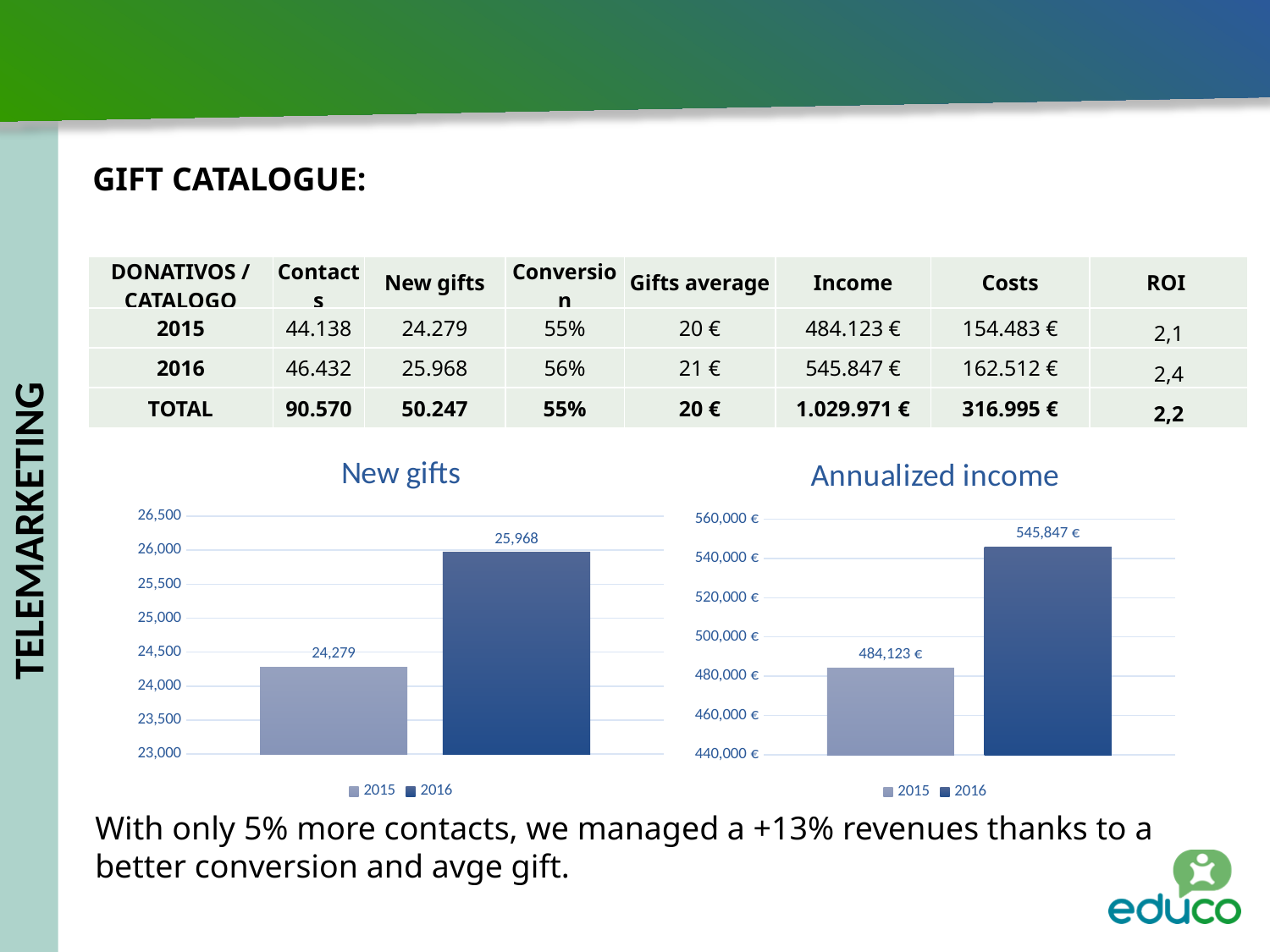
In the "New gifts" chart, what is the difference between the 2016 and 2015 values? 1,689 In the "Annualized income" chart, what is the value for 2015? 484,123 € In the "New gifts" chart, what is the value for 2016? 25,968 In the "Annualized income" chart, what is the value for 2016? 545,847 € In the "Annualized income" chart, how much higher is the 2016 value than the 2015 value? 61,724 € In the "New gifts" chart, which year has the higher value? 2016 How many series does the legend of the "Annualized income" chart list? 2 In the "Annualized income" chart, which year has the lower value? 2015 In the "Annualized income" chart, is the value for 2015 greater or less than 500,000 €? less In the "New gifts" chart, what is the value for 2015? 24,279 What type of chart is the "New gifts" chart? bar chart In the "New gifts" chart, is the value for 2016 greater or less than 25,500? greater